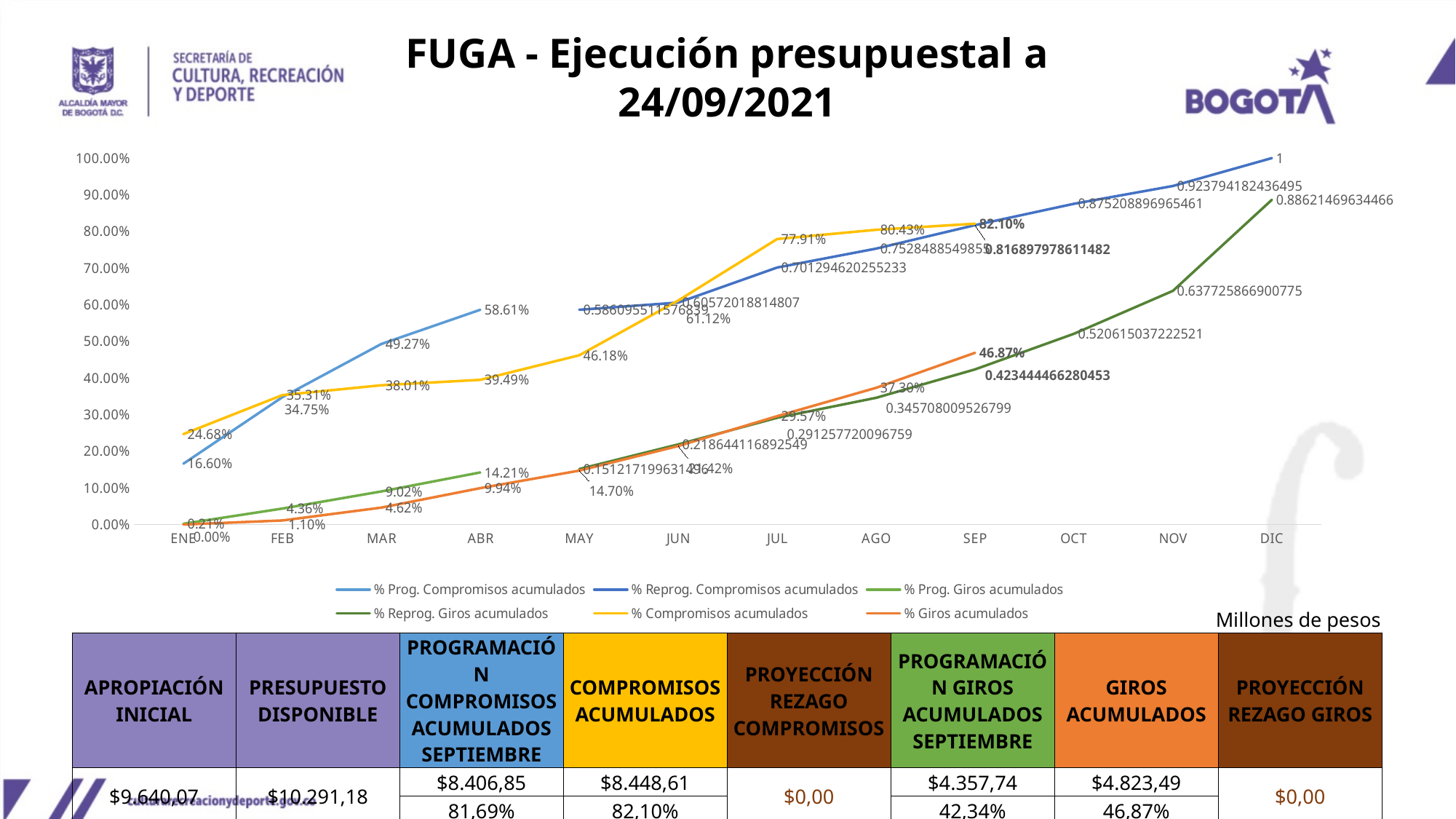
What is the value of % Prog. Giros acumulados in ABR? 14.21% How many series does the chart legend list? 6 What is the title of the chart on the slide? FUGA - Ejecución presupuestal a 24/09/2021 What is the value of % Prog. Compromisos acumulados in ABR? 58.61% What is the value of % Compromisos acumulados in JUL? 77.91% What is the value of % Giros acumulados in SEP? 46.87% Is the value of % Reprog. Giros acumulados in NOV greater or less than 60%? greater What is the difference between % Compromisos acumulados and % Giros acumulados in SEP? 35.23% What is the value of % Compromisos acumulados in SEP? 82.10% How many months are shown along the x axis of the chart? 12 What kind of chart is shown on the slide? line chart Does % Compromisos acumulados rise or fall from ENE to SEP? rise